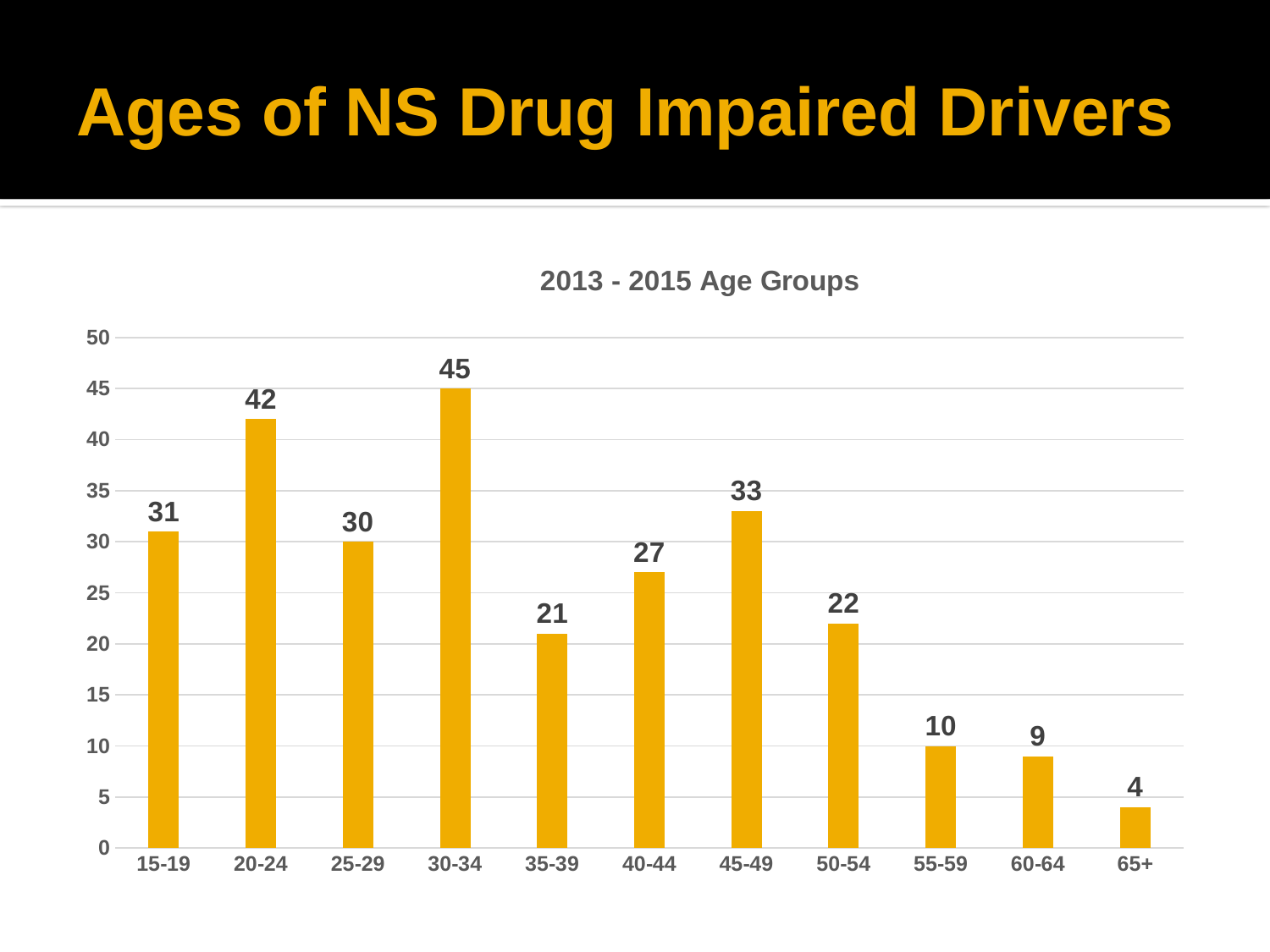
What is the value for the 50-54 age group? 22 What is the title of the chart? 2013 - 2015 Age Groups What is the value for the 65+ age group? 4 What is the difference between the values for the 20-24 and 35-39 age groups? 21 Which is larger, the value for 15-19 or the value for 25-29? 15-19 Which age group has the lowest value? 65+ What kind of chart is shown on the slide? Bar chart Do the values generally rise or fall from the 45-49 age group to the 65+ age group? Fall What is the value for the 30-34 age group? 45 Which age group has the highest value? 30-34 How many age groups are shown on the x axis? 11 Is the value for the 45-49 age group greater or less than 30? greater